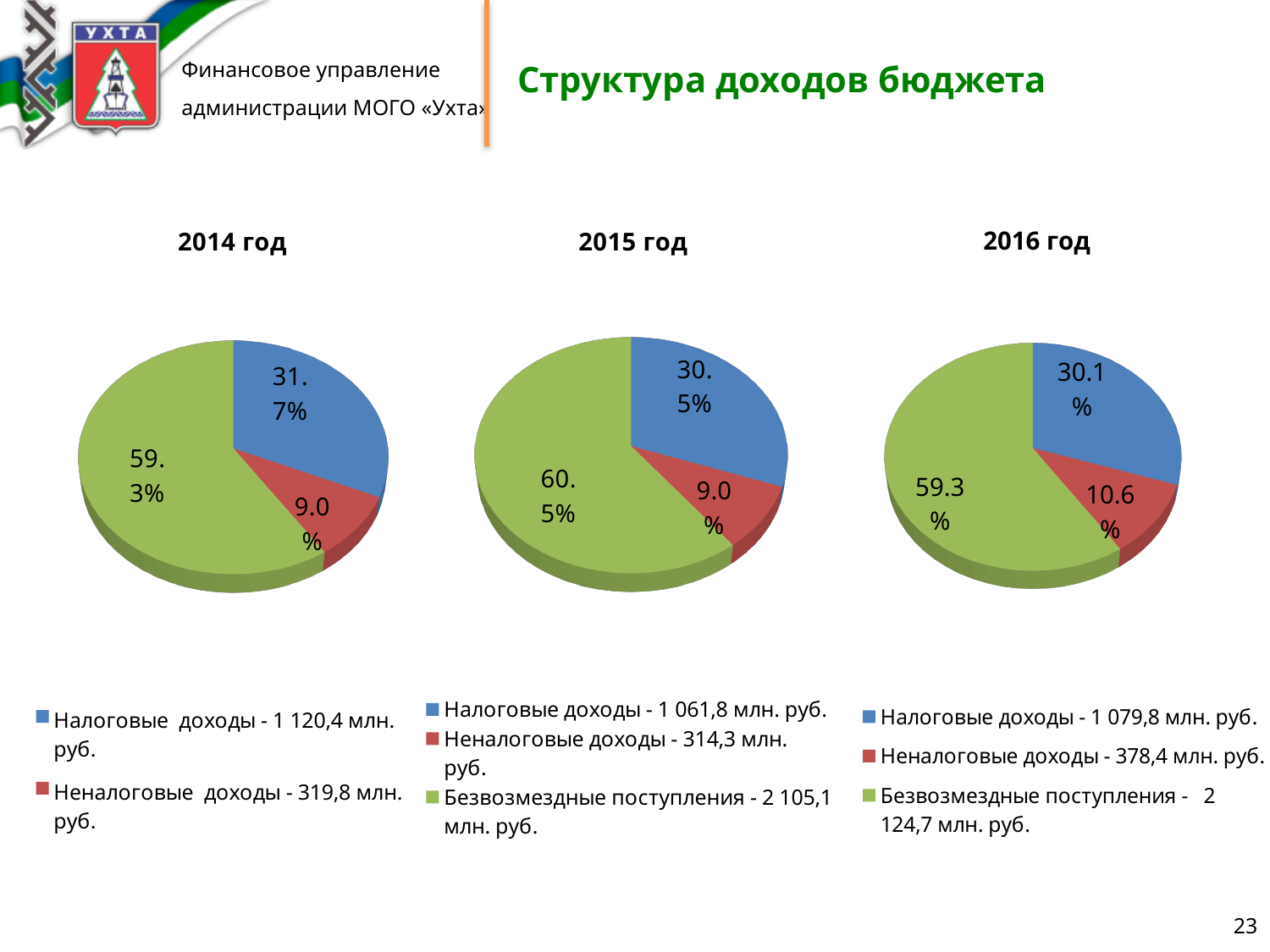
In the 2016 год pie chart, what is the difference between the shares of the blue slice (30.1%) and the red slice (10.6%)? 19.5% In the 2015 год pie chart, what share is shown for the blue slice (Налоговые доходы)? 30.5% How many slices does the 2016 год pie chart have? 3 In the 2014 год pie chart, which is larger: the blue slice (Налоговые доходы) or the red slice (Неналоговые доходы)? Налоговые доходы In the 2016 год pie chart, which slice is the largest? Безвозмездные поступления In the 2016 год pie chart, what share is shown for the red slice (Неналоговые доходы)? 10.6% In the 2014 год pie chart, what share is shown for the red slice (Неналоговые доходы)? 9.0% What kind of chart is used for the 2014 год chart? pie chart In the 2015 год pie chart, which slice is the smallest? Неналоговые доходы According to the legend of the 2016 год chart, what amount is given for Неналоговые доходы? 378,4 млн. руб.